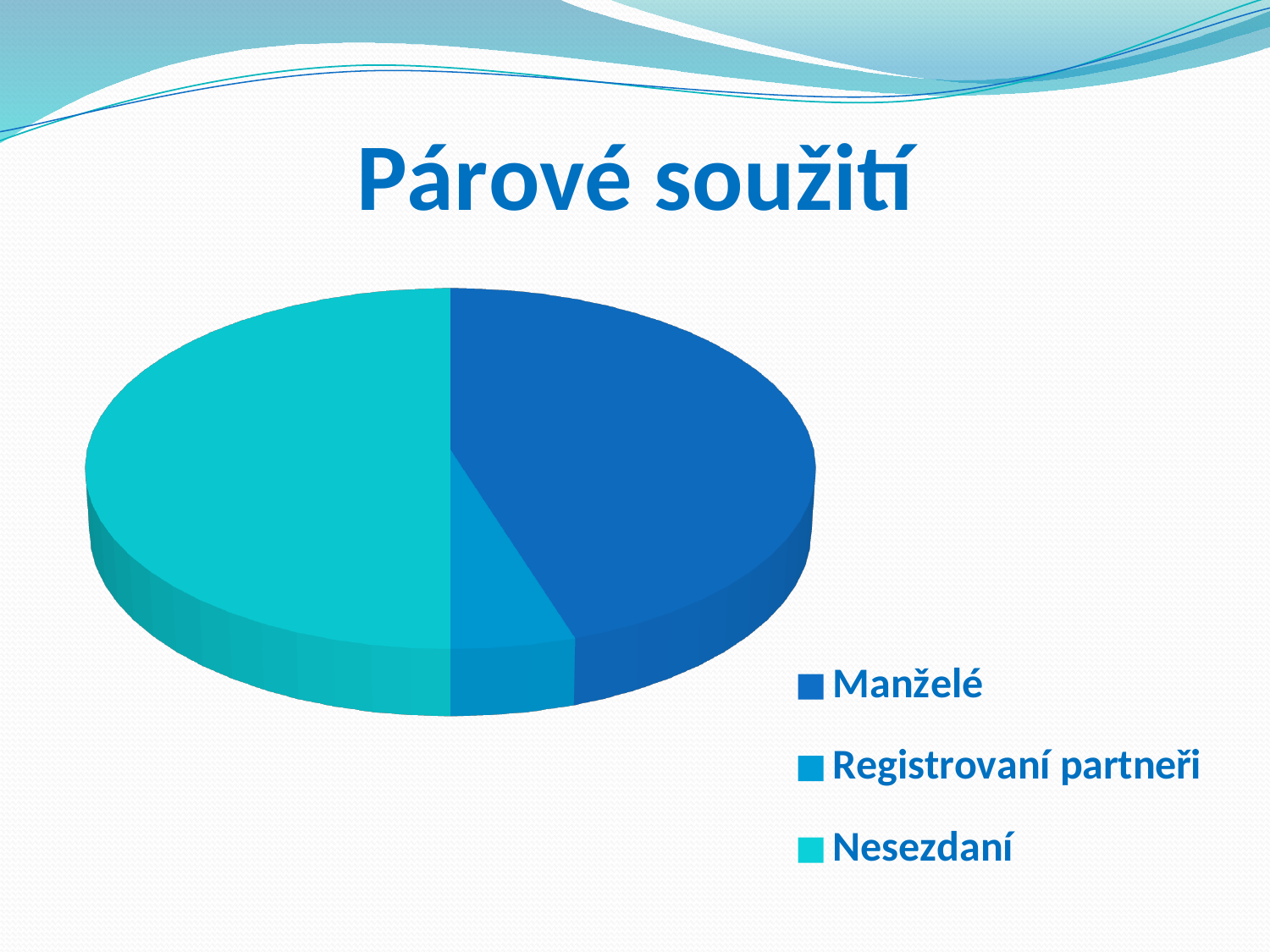
What kind of chart is shown on the slide? pie chart Which slice is larger, Manželé or Registrovaní partneři? Manželé How many slices does the pie chart have? 3 How many entries does the legend of the pie chart list? 3 What is the title of the slide containing the pie chart? Párové soužití Which slice is larger, Nesezdaní or Registrovaní partneři? Nesezdaní Which slice is larger, Nesezdaní or Manželé? Nesezdaní Which category has the smallest slice in the pie chart? Registrovaní partneři Which category is shown in the darkest blue colour in the pie chart? Manželé Which category has the largest slice in the pie chart? Nesezdaní